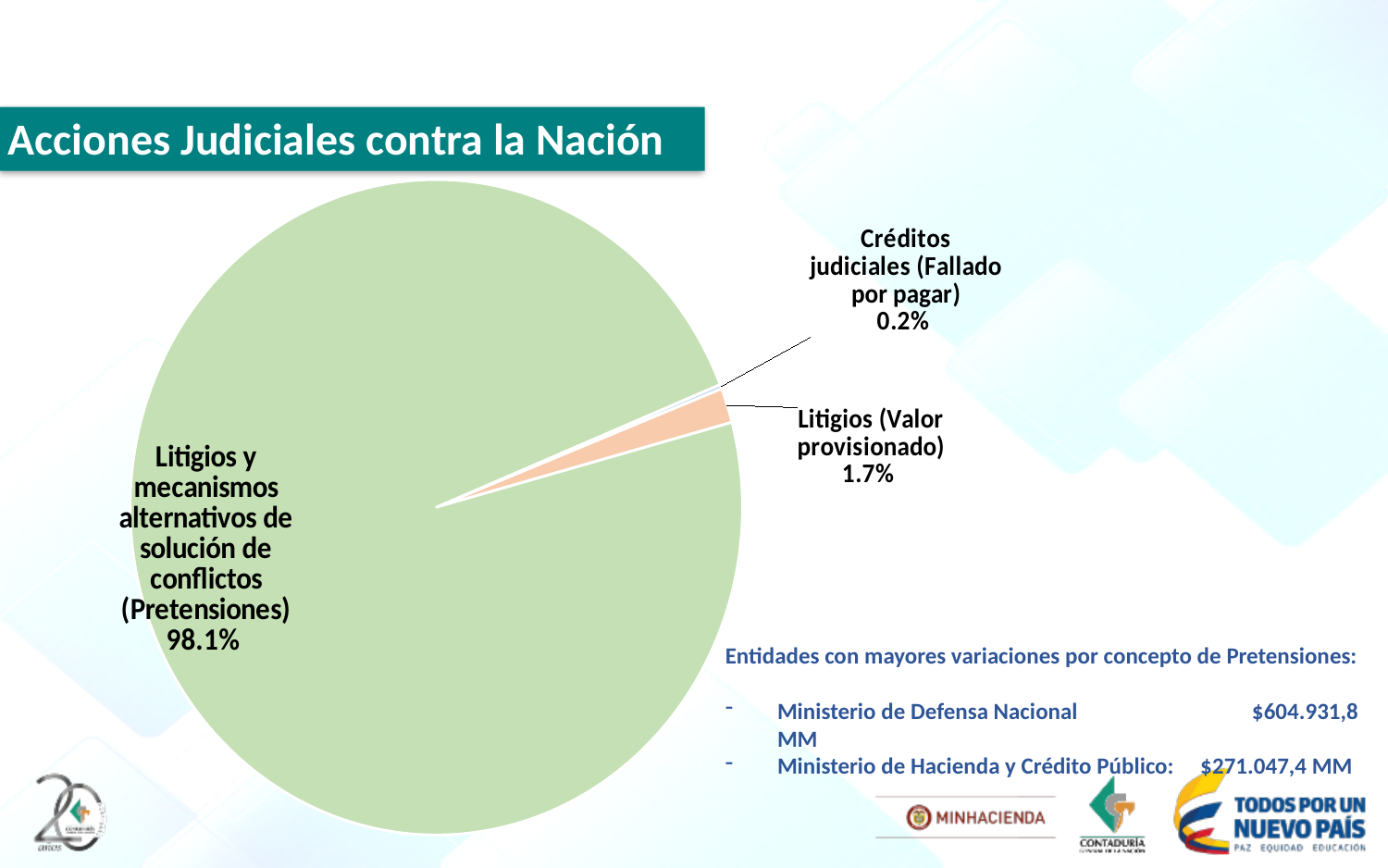
What share of the pie does "Créditos judiciales (Fallado por pagar)" represent? 0.2% Which slice of the pie chart is the largest? Litigios y mecanismos alternativos de solución de conflictos (Pretensiones) What is the title shown in the header box above the pie chart? Acciones Judiciales contra la Nación What kind of chart is shown on the slide? Pie chart How many slices does the pie chart have? 3 What share of the pie does "Litigios y mecanismos alternativos de solución de conflictos (Pretensiones)" represent? 98.1% Which slice of the pie chart is the smallest? Créditos judiciales (Fallado por pagar) What is the difference in percentage points between the "Litigios (Valor provisionado)" slice and the "Créditos judiciales (Fallado por pagar)" slice? 1.5% What share of the pie does "Litigios (Valor provisionado)" represent? 1.7% Which is larger: the share for "Litigios (Valor provisionado)" or the share for "Créditos judiciales (Fallado por pagar)"? Litigios (Valor provisionado) What colour is the largest slice of the pie chart? Green What is the difference in percentage points between the "Pretensiones" slice and the "Litigios (Valor provisionado)" slice? 96.4%